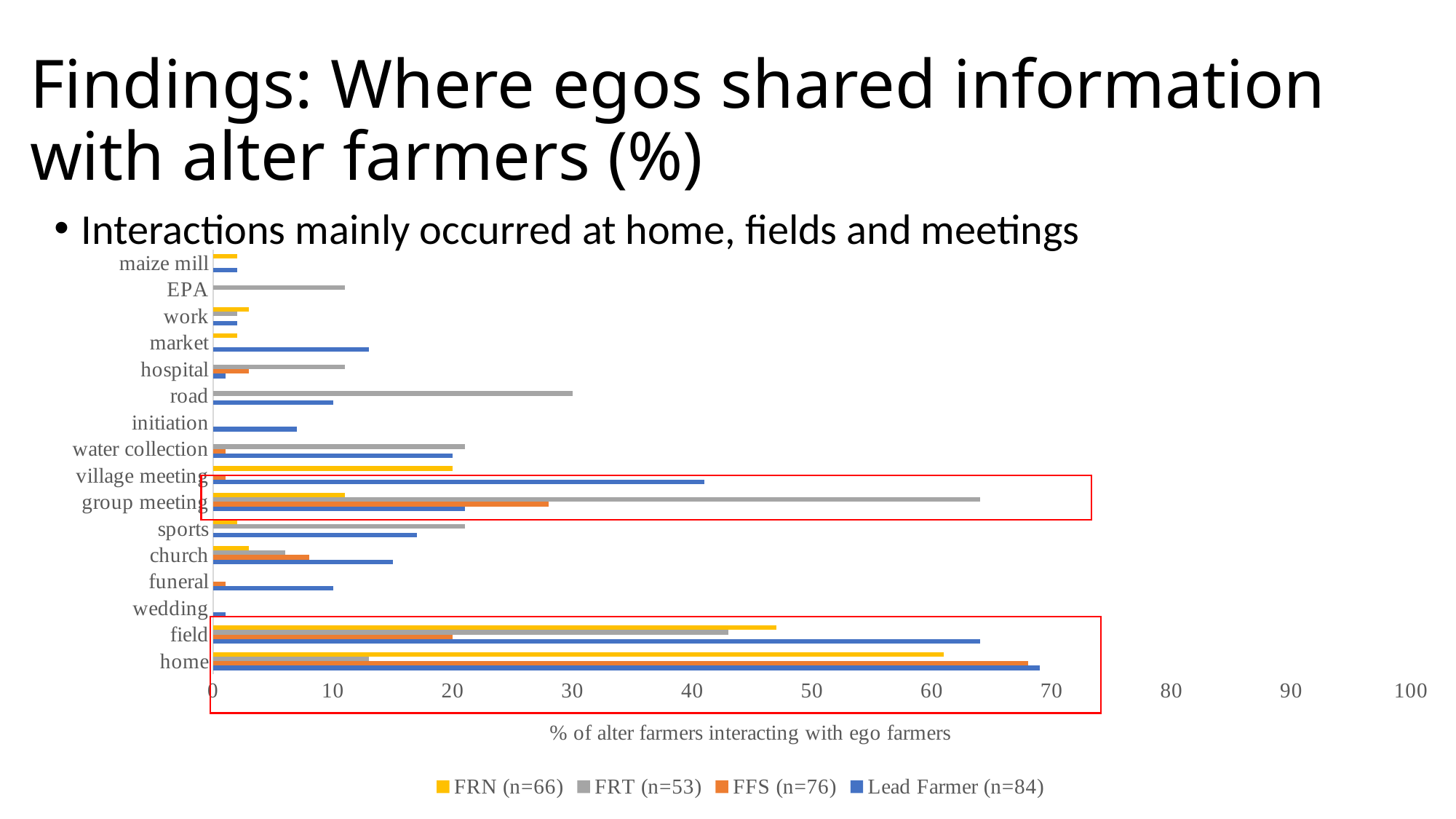
For field, which is larger: the Lead Farmer value or the FFS value? Lead Farmer How many location categories are plotted on the y axis? 16 For group meeting, which is larger: the FRT value or the FRN value? FRT What is the x-axis title of the chart? % of alter farmers interacting with ego farmers Which category has the highest FRT value? group meeting Is the FRT value for road greater or less than 20? greater Which series in the legend has a sample size of n=84? Lead Farmer What kind of chart is shown on the slide? bar chart How many series does the legend list? 4 Is the Lead Farmer value for home greater or less than 60? greater Is the FRT value for group meeting greater or less than 60? greater